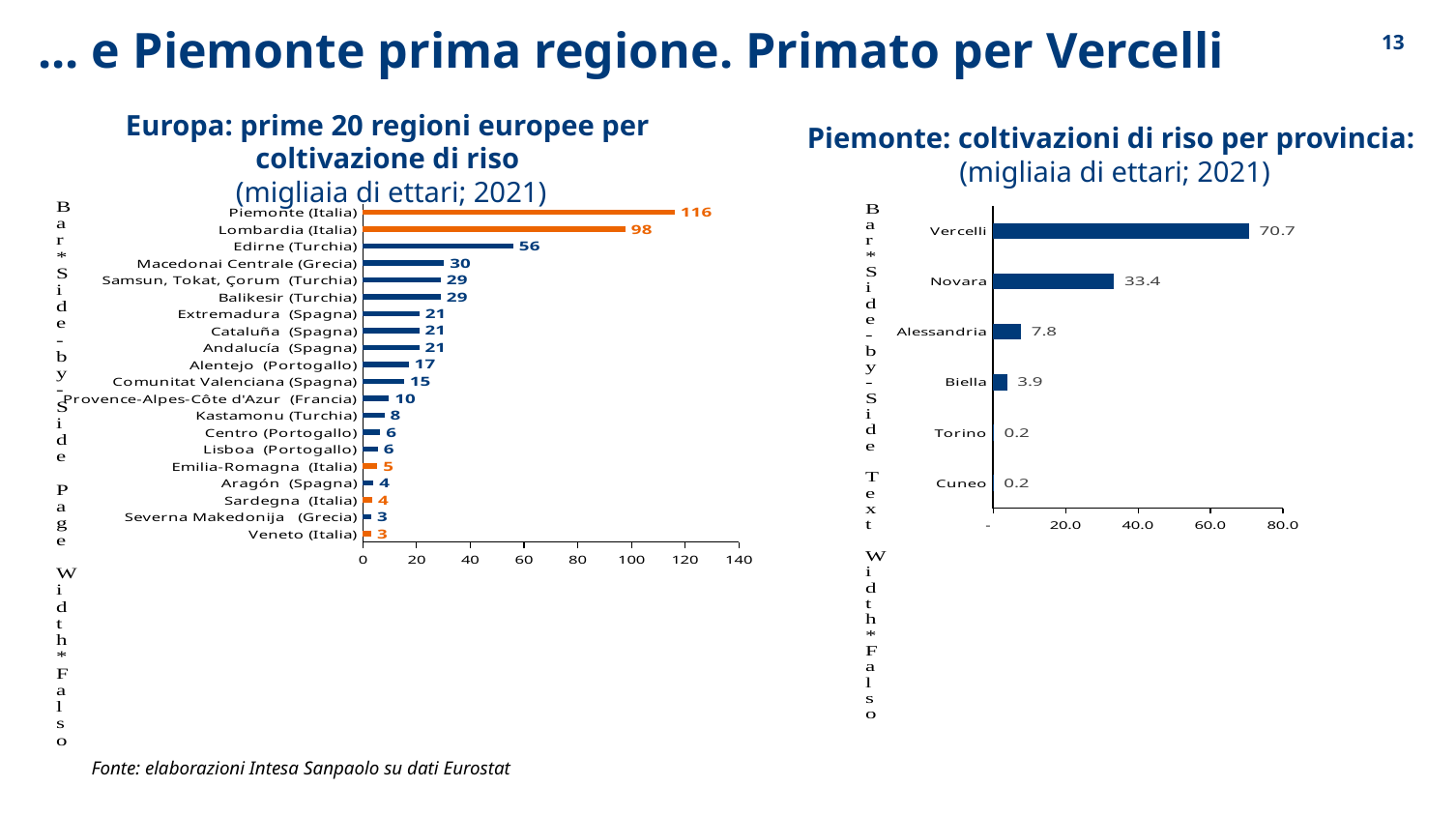
In the chart 'Piemonte: coltivazioni di riso per provincia', what is the value for Novara? 33.4 In the chart 'Europa: prime 20 regioni europee per coltivazione di riso', what is the value for Emilia-Romagna (Italia)? 5 In the chart 'Piemonte: coltivazioni di riso per provincia', what is the difference between Vercelli and Novara? 37.3 In the chart 'Europa: prime 20 regioni europee per coltivazione di riso', what is the value for Edirne (Turchia)? 56 In the chart 'Europa: prime 20 regioni europee per coltivazione di riso', which is larger: Macedonai Centrale (Grecia) or Extremadura (Spagna)? Macedonai Centrale (Grecia) What type of chart is 'Piemonte: coltivazioni di riso per provincia'? Bar chart In the chart 'Piemonte: coltivazioni di riso per provincia', how many provinces are shown? 6 In the chart 'Europa: prime 20 regioni europee per coltivazione di riso', what is the value for Piemonte (Italia)? 116 In the chart 'Piemonte: coltivazioni di riso per provincia', what is the value for Vercelli? 70.7 In the chart 'Europa: prime 20 regioni europee per coltivazione di riso', how many regions are shown? 20 In the chart 'Europa: prime 20 regioni europee per coltivazione di riso', what is the difference between Piemonte (Italia) and Lombardia (Italia)? 18 In the chart 'Europa: prime 20 regioni europee per coltivazione di riso', which region has the highest value? Piemonte (Italia)